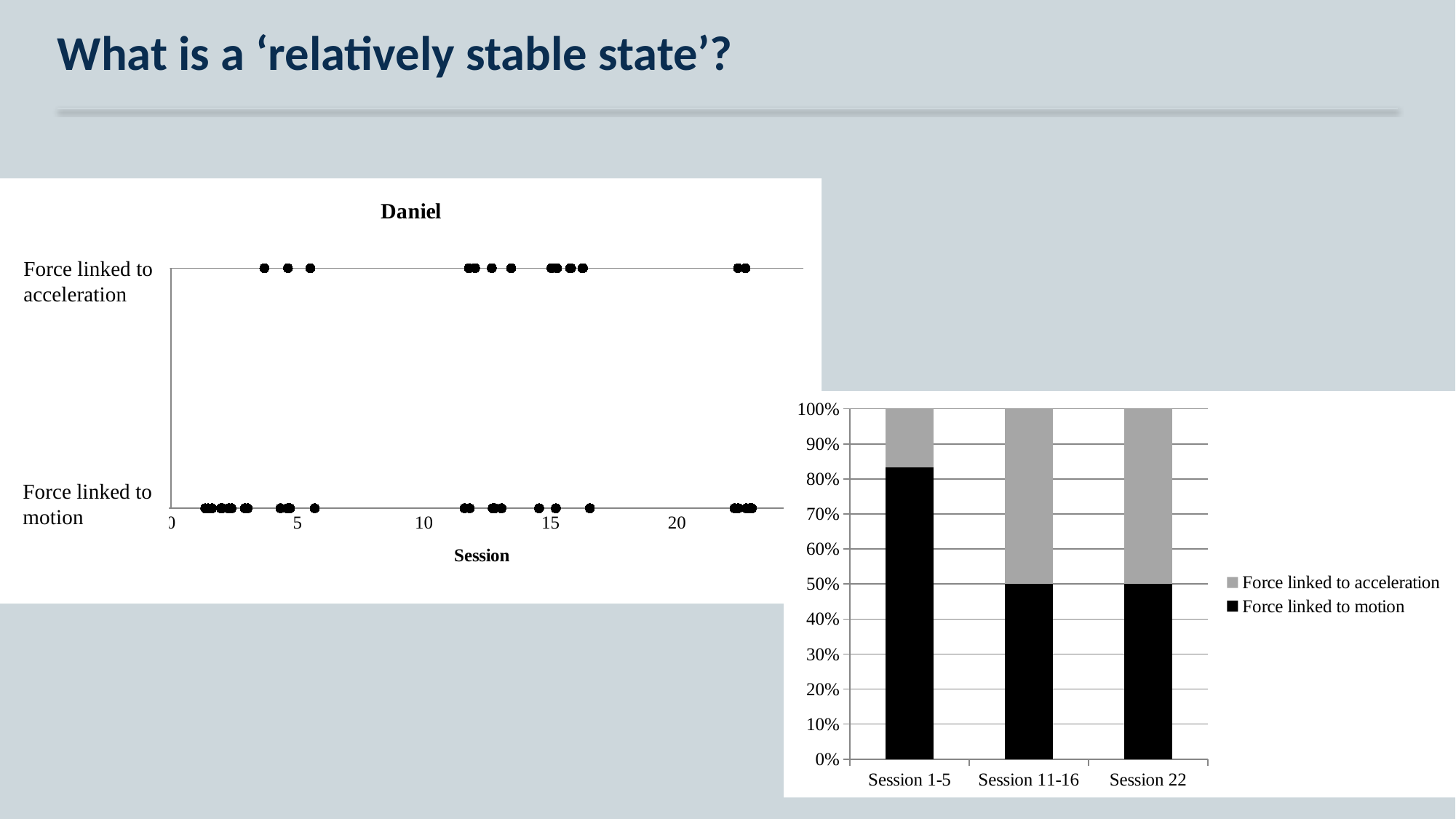
In the stacked bar chart on the right, what is the value of 'Force linked to acceleration' for Session 22? 50% In the stacked bar chart on the right, which is larger for Session 1-5: 'Force linked to motion' or 'Force linked to acceleration'? Force linked to motion In the stacked bar chart on the right, is the value of 'Force linked to acceleration' for Session 1-5 greater or less than 20%? less In the stacked bar chart on the right, which category has the highest share of 'Force linked to motion'? Session 1-5 What is the x-axis label of the chart titled 'Daniel'? Session What kind of chart is the chart titled 'Daniel'? scatter chart What kind of chart is the chart on the right of the slide? stacked bar chart How many series does the legend of the stacked bar chart on the right list? 2 How many categories are shown on the x axis of the stacked bar chart on the right? 3 In the stacked bar chart on the right, is the value of 'Force linked to motion' for Session 1-5 greater or less than 80%? greater What is the title of the chart on the left of the slide? Daniel In the stacked bar chart on the right, what is the value of 'Force linked to motion' for Session 11-16? 50%